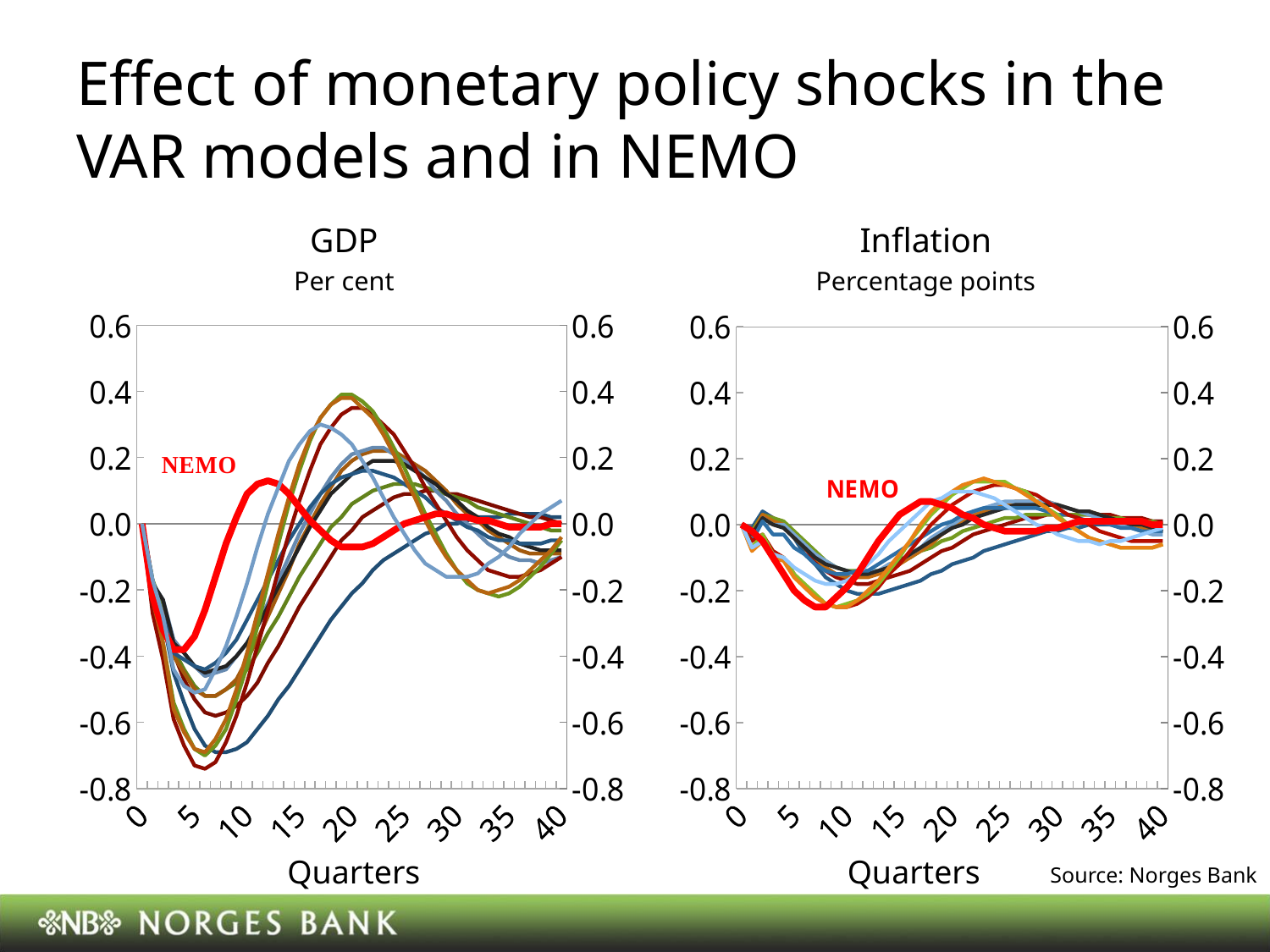
What is the x-axis label on the GDP chart? Quarters What is the unit shown under the title of the Inflation chart? Percentage points In the GDP chart, is the NEMO line's value at quarter 5 greater or less than -0.2? less In the GDP chart, does the NEMO line rise or fall between quarter 0 and quarter 5? fall In the GDP chart, which is larger for the NEMO line: the value at quarter 5 or the value at quarter 12? quarter 12 In the Inflation chart, which is larger for the NEMO line: the value at quarter 8 or the value at quarter 18? quarter 18 In the Inflation chart, is the lowest point of the NEMO line greater or less than -0.4? greater In the Inflation chart, does the NEMO line rise or fall between quarter 0 and quarter 8? fall In the Inflation chart, is the highest point of the NEMO line greater or less than 0.2? less What kind of chart is the GDP chart on the left? Line chart